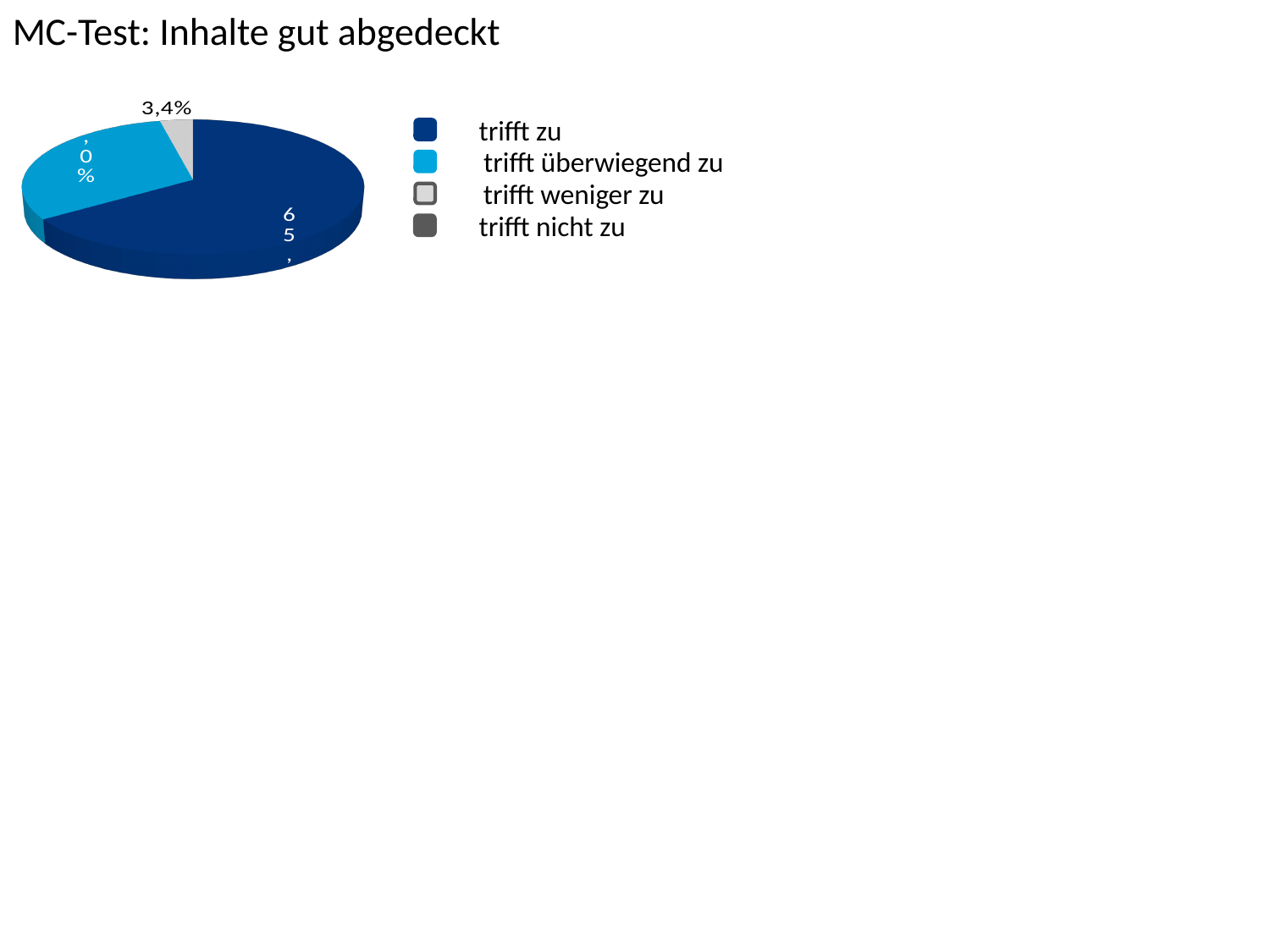
What percentage is shown for the 'trifft weniger zu' slice? 3,4% Which is larger, the slice for 'trifft überwiegend zu' or the slice for 'trifft weniger zu'? trifft überwiegend zu How many slices are visible in the pie chart? 3 How many entries does the legend of the pie chart list? 4 Which legend entry is shown in dark blue? trifft zu What is the title of the chart on the slide? MC-Test: Inhalte gut abgedeckt Which is larger, the slice for 'trifft zu' or the slice for 'trifft überwiegend zu'? trifft zu Which category has the largest slice of the pie? trifft zu What kind of chart is shown on the slide? pie chart Is the share of the 'trifft zu' slice greater or less than 50%? greater